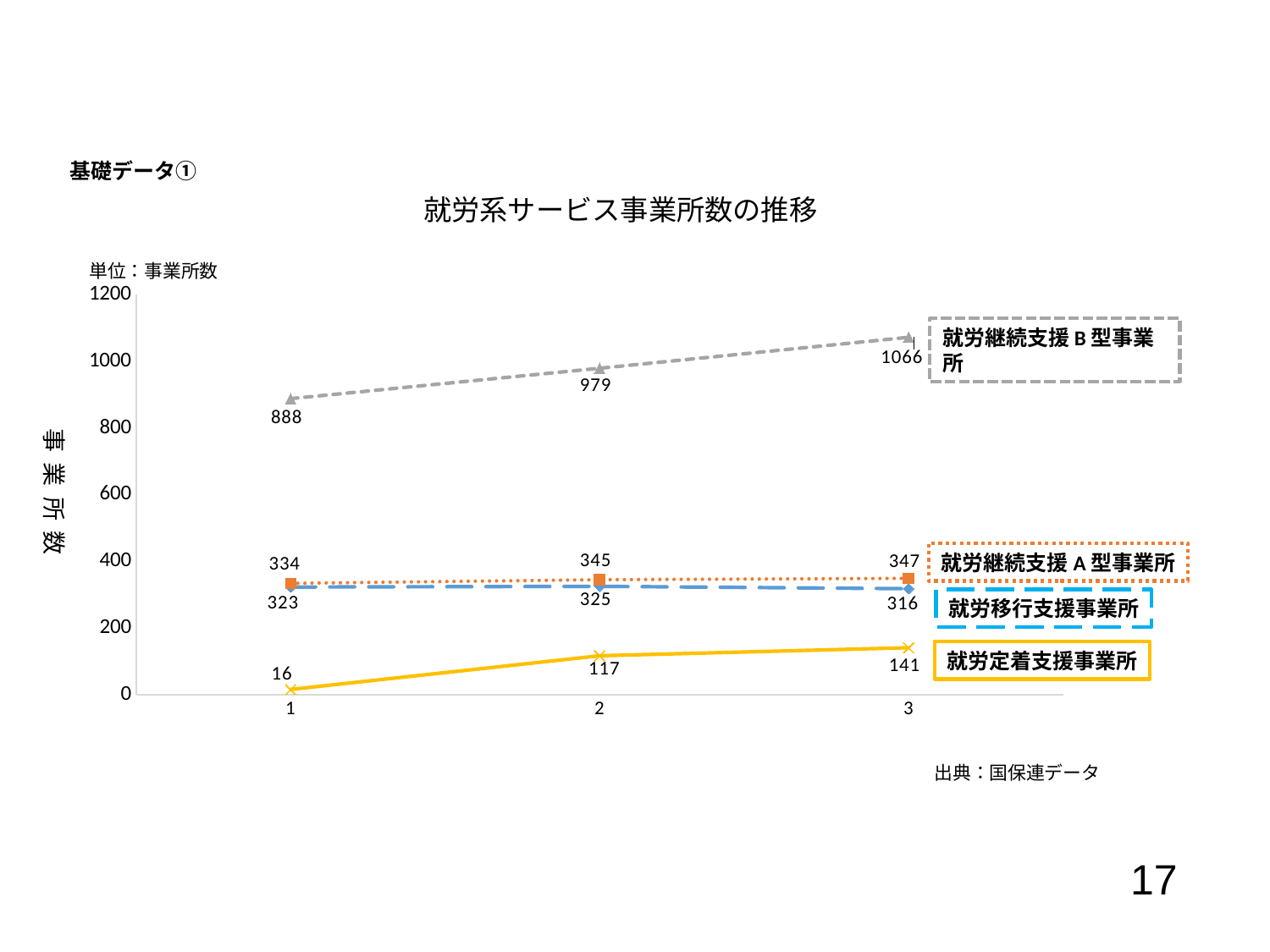
Does the value for 就労定着支援事業所 rise or fall from x = 1 to x = 3? rise What is the value for 就労移行支援事業所 at x = 2? 325 Which series has the lowest value at x = 1? 就労定着支援事業所 What is the difference between 就労継続支援A型事業所 and 就労移行支援事業所 at x = 3? 31 Which is larger at x = 2: 就労継続支援B型事業所 or 就労定着支援事業所? 就労継続支援B型事業所 What is the value for 就労継続支援A型事業所 at x = 3? 347 How many points are plotted along the x axis for each series? 3 What is the value for 就労継続支援B型事業所 at x = 3? 1066 Which series has the highest value at x = 3? 就労継続支援B型事業所 By how much did 就労継続支援B型事業所 increase from x = 1 to x = 3? 178 How many series are shown in the chart? 4 What is the value for 就労定着支援事業所 at x = 1? 16